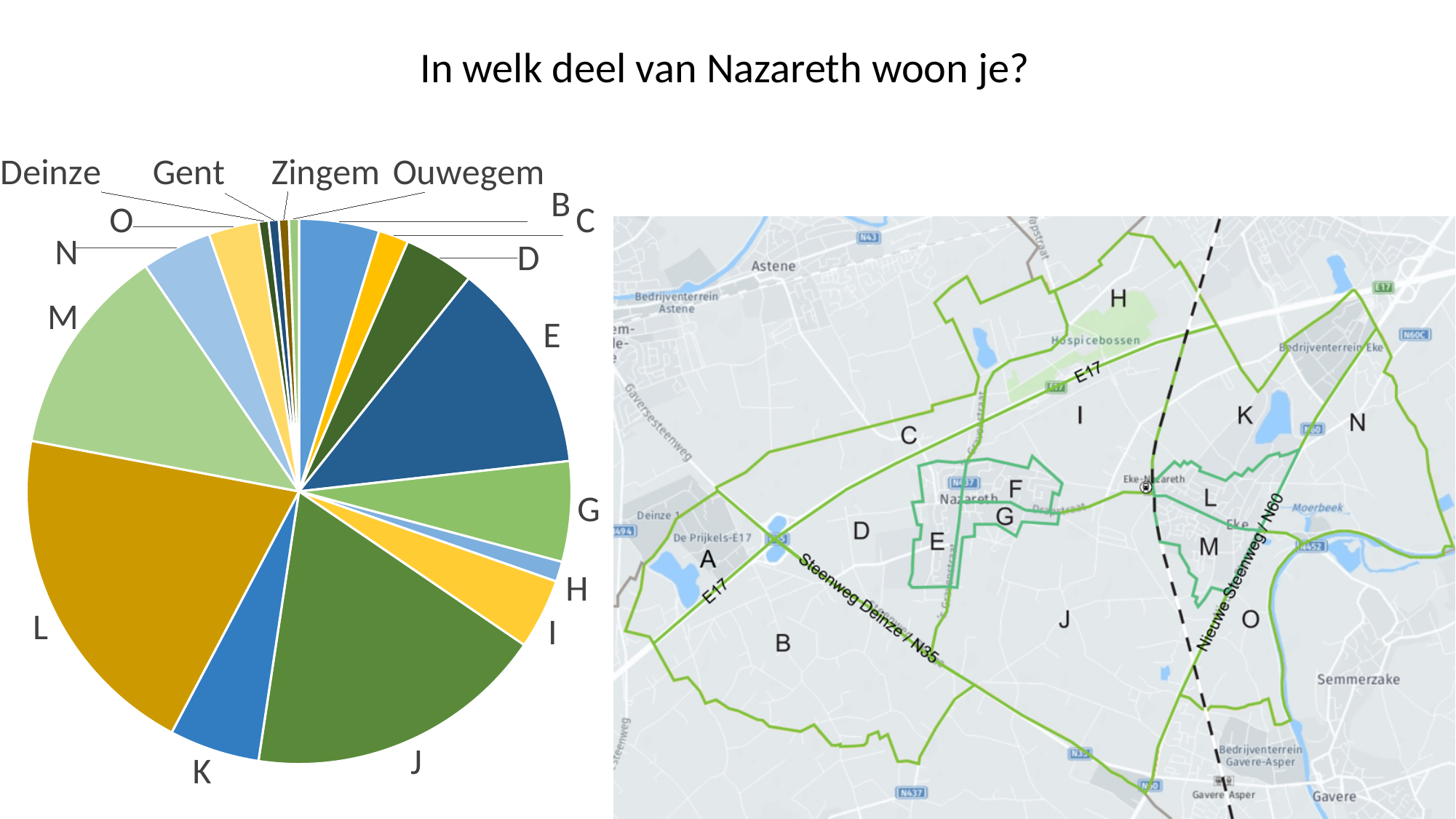
In the pie chart, which slice is larger, M or N? M What kind of chart is shown on the left of the slide? pie chart In the pie chart, which slice is larger, I or H? I What is the title of the slide containing the pie chart? In welk deel van Nazareth woon je? Which category has the largest slice in the pie chart? L In the pie chart, which slice is larger, L or K? L Which four labels on the pie chart are place names rather than letters? Deinze, Gent, Zingem, Ouwegem